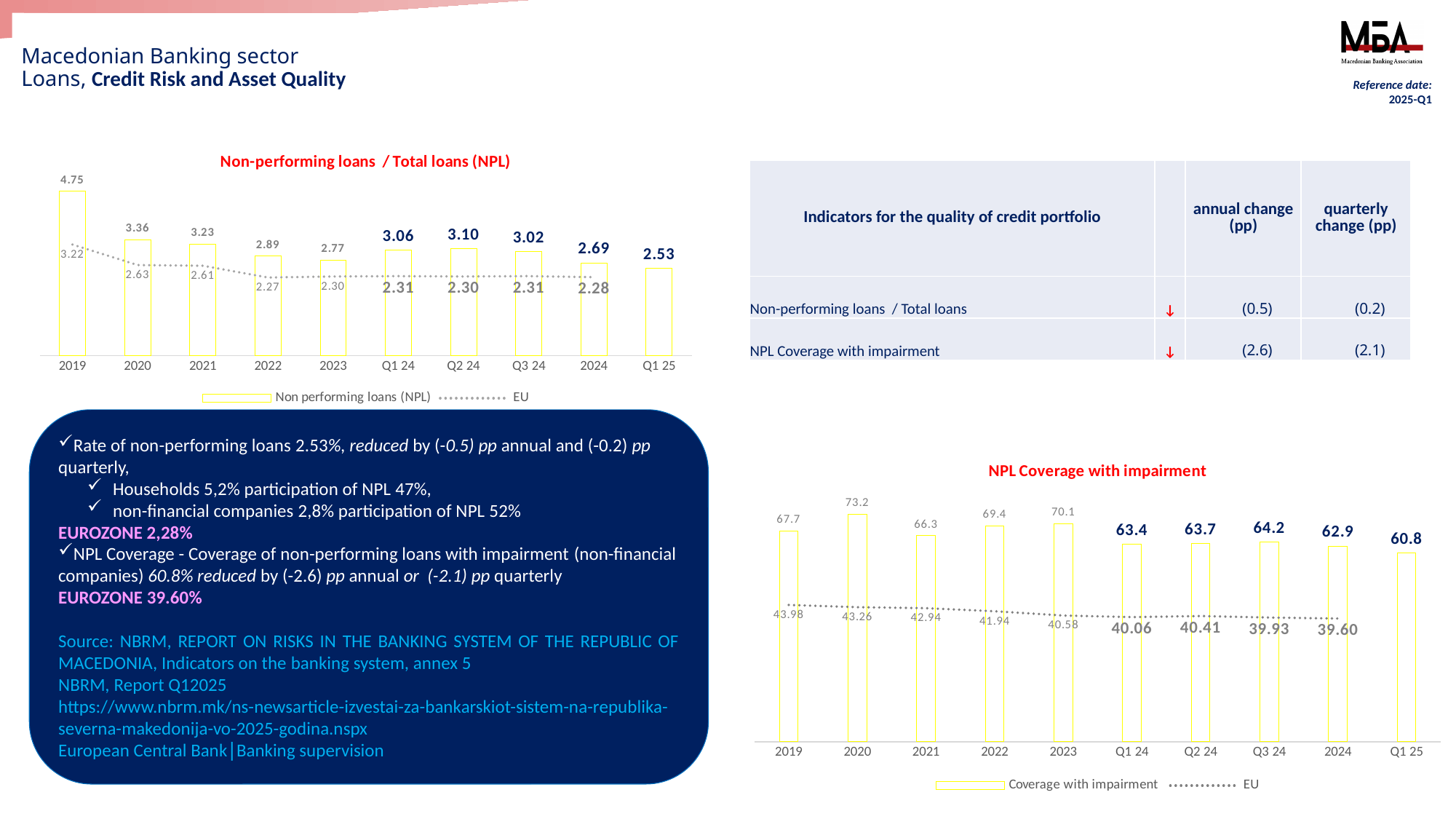
In the 'Non-performing loans / Total loans (NPL)' chart, what is the NPL value for Q1 25? 2.53 In the 'Non-performing loans / Total loans (NPL)' chart, what is the difference between the NPL values for 2024 and Q1 25? 0.16 In the 'NPL Coverage with impairment' chart, what is the EU value for 2024? 39.60 In the 'NPL Coverage with impairment' chart, what is the coverage value for 2020? 73.2 In the 'Non-performing loans / Total loans (NPL)' chart, what is the NPL value for 2019? 4.75 How many categories are shown on the x axis of the 'NPL Coverage with impairment' chart? 10 How many series does the legend of the 'Non-performing loans / Total loans (NPL)' chart list? 2 What kind of chart is the 'NPL Coverage with impairment' chart? Bar chart with a line In the 'NPL Coverage with impairment' chart, which category has the lowest coverage bar? Q1 25 In the 'NPL Coverage with impairment' chart, is the coverage value larger for Q3 24 or for 2024? Q3 24 In the 'Non-performing loans / Total loans (NPL)' chart, what is the EU value for 2024? 2.28 In the 'Non-performing loans / Total loans (NPL)' chart, which category has the highest NPL bar? 2019